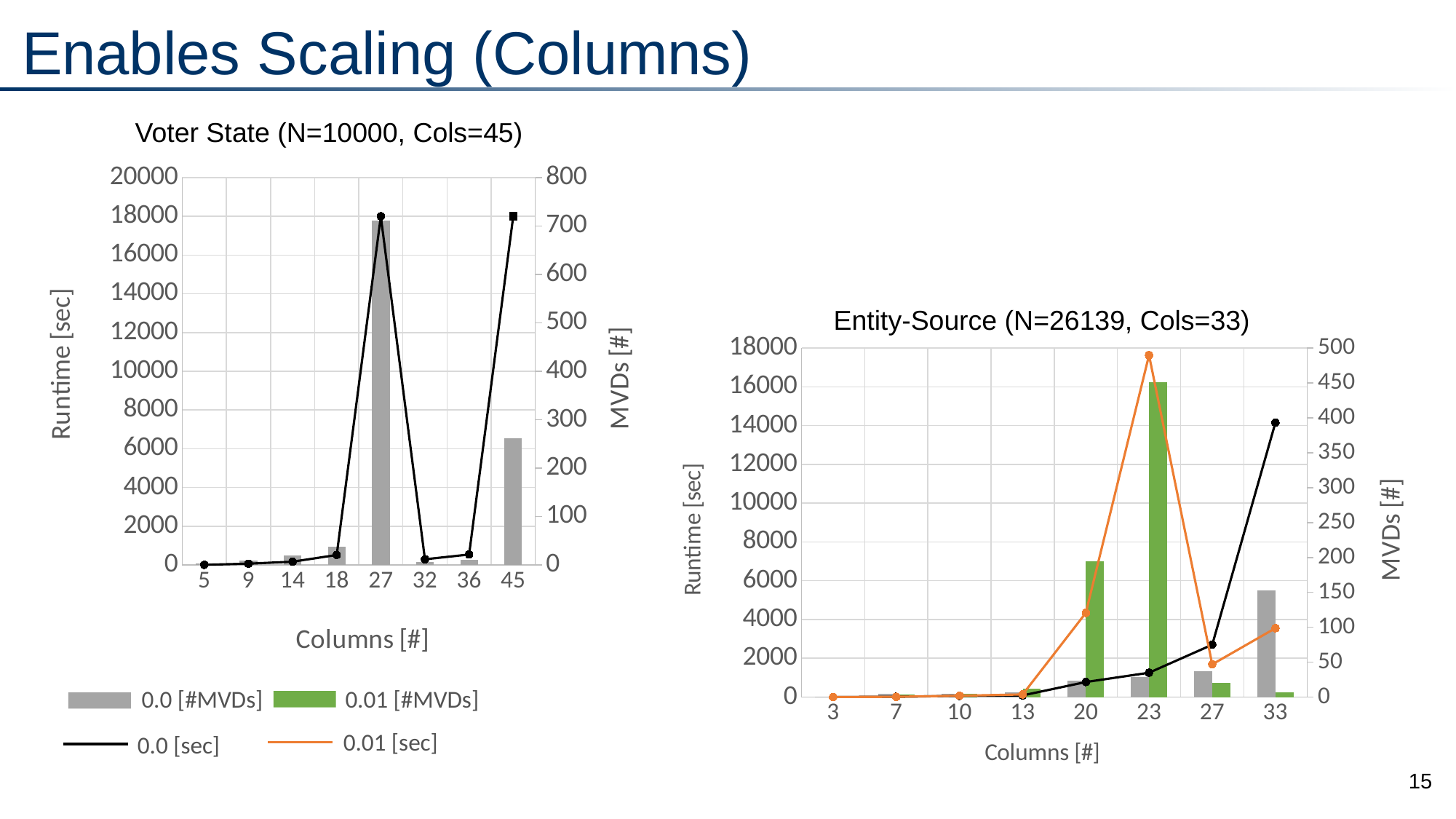
In the Entity-Source chart, which has the taller green bar, 20 columns or 23 columns? 23 In the Voter State chart, is the gray bar at 45 columns greater or less than 8000? less How many series does the legend on the slide list? 4 What kind of chart is the Entity-Source chart? Combined bar and line chart In the Voter State chart, at which column count is the gray bar tallest? 27 In the Voter State chart, which has the taller gray bar, 27 columns or 45 columns? 27 In the Voter State chart, how many column counts are shown on the x axis? 8 In the Entity-Source chart, at which column count is the green bar tallest? 23